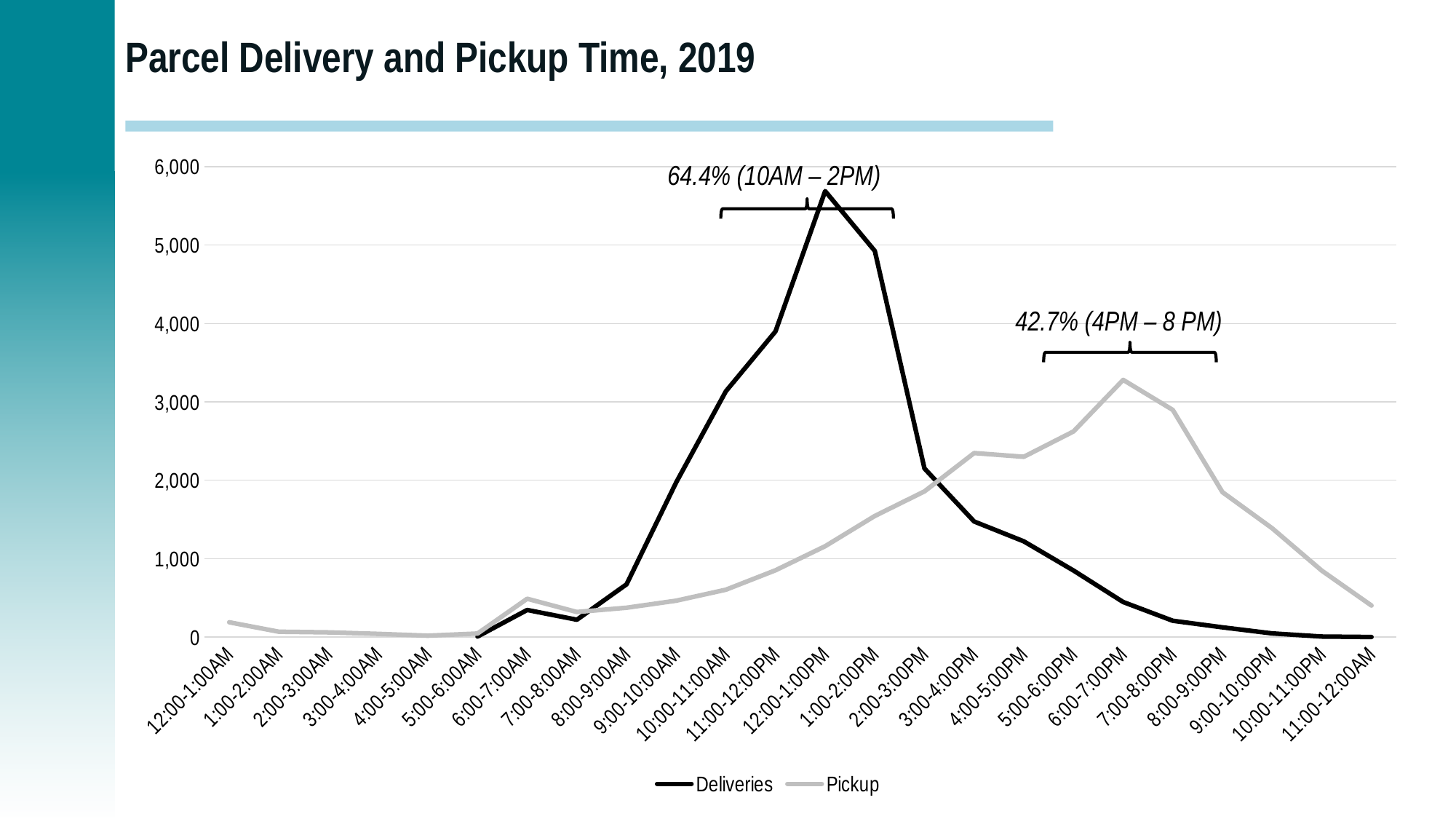
At 12:00-1:00PM, which series has the larger value, Deliveries or Pickup? Deliveries What kind of chart is shown on the slide? Line chart What percentage does the annotation give for the 10AM – 2PM window? 64.4% Is the Deliveries value for 4:00-5:00PM greater or less than 2,000? less Is the Pickup value for 6:00-7:00PM greater or less than 3,000? greater In which time slot does the Deliveries series reach its highest value? 12:00-1:00PM Is the Deliveries value for 12:00-1:00PM greater or less than 5,000? greater In which time slot does the Pickup series reach its highest value? 6:00-7:00PM At 6:00-7:00PM, which series has the larger value, Deliveries or Pickup? Pickup How many series does the legend list? 2 How many hourly time slots are shown on the x axis? 24 Does the Deliveries series rise or fall from 12:00-1:00PM to 5:00-6:00PM? Fall